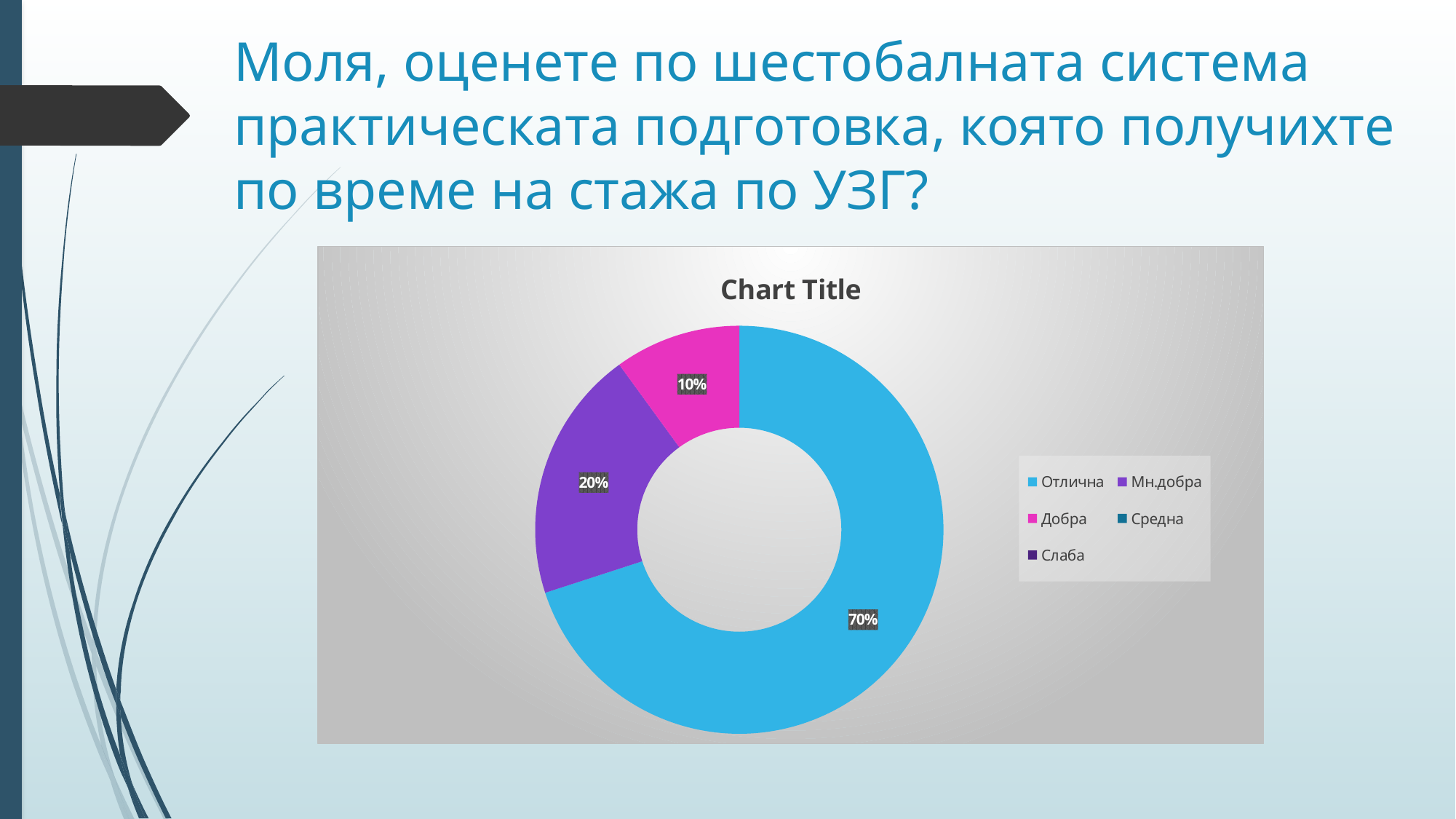
What percentage is shown for Мн.добра? 20% What kind of chart is shown on the slide? doughnut chart What percentage is shown for Отлична? 70% Which is larger, the share for Мн.добра or the share for Добра? Мн.добра Which of the labelled slices has the smallest share? Добра How many entries does the chart legend list? 5 Which category has the largest share of the chart? Отлична How many slices with data labels are visible in the chart? 3 What percentage is shown for Добра? 10% What is the difference in percentage points between Отлична and Мн.добра? 50 What colour is the slice for Отлична? light blue What is the title of the chart? Chart Title